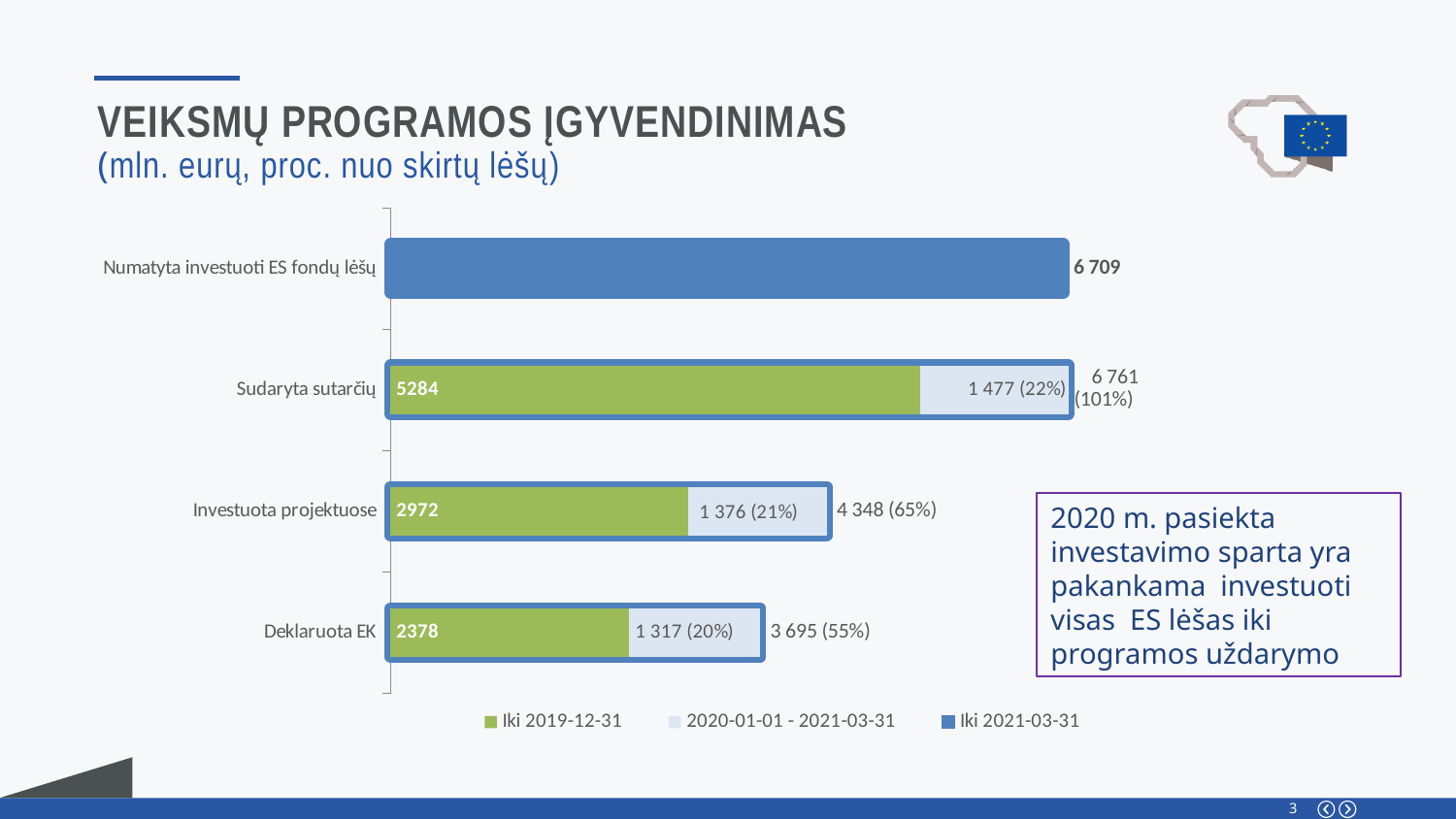
What is the difference between the 'Iki 2019-12-31' values for 'Sudaryta sutarčių' and 'Investuota projektuose'? 2312 What type of chart is shown on the slide? bar chart How many categories are shown on the chart? 4 Which category has the lowest total value? Deklaruota EK What is the total shown for the 'Deklaruota EK' bar? 3 695 (55%) Which is larger: the 'Iki 2019-12-31' value for 'Investuota projektuose' or for 'Deklaruota EK'? Investuota projektuose What is the 'Iki 2019-12-31' value for 'Sudaryta sutarčių'? 5284 What is the total shown for the 'Sudaryta sutarčių' bar? 6 761 (101%) How many series does the legend list? 3 What is the value for 'Numatyta investuoti ES fondų lėšų'? 6 709 What is the 'Iki 2019-12-31' value for 'Deklaruota EK'? 2378 What is the '2020-01-01 - 2021-03-31' value for 'Investuota projektuose'? 1 376 (21%)